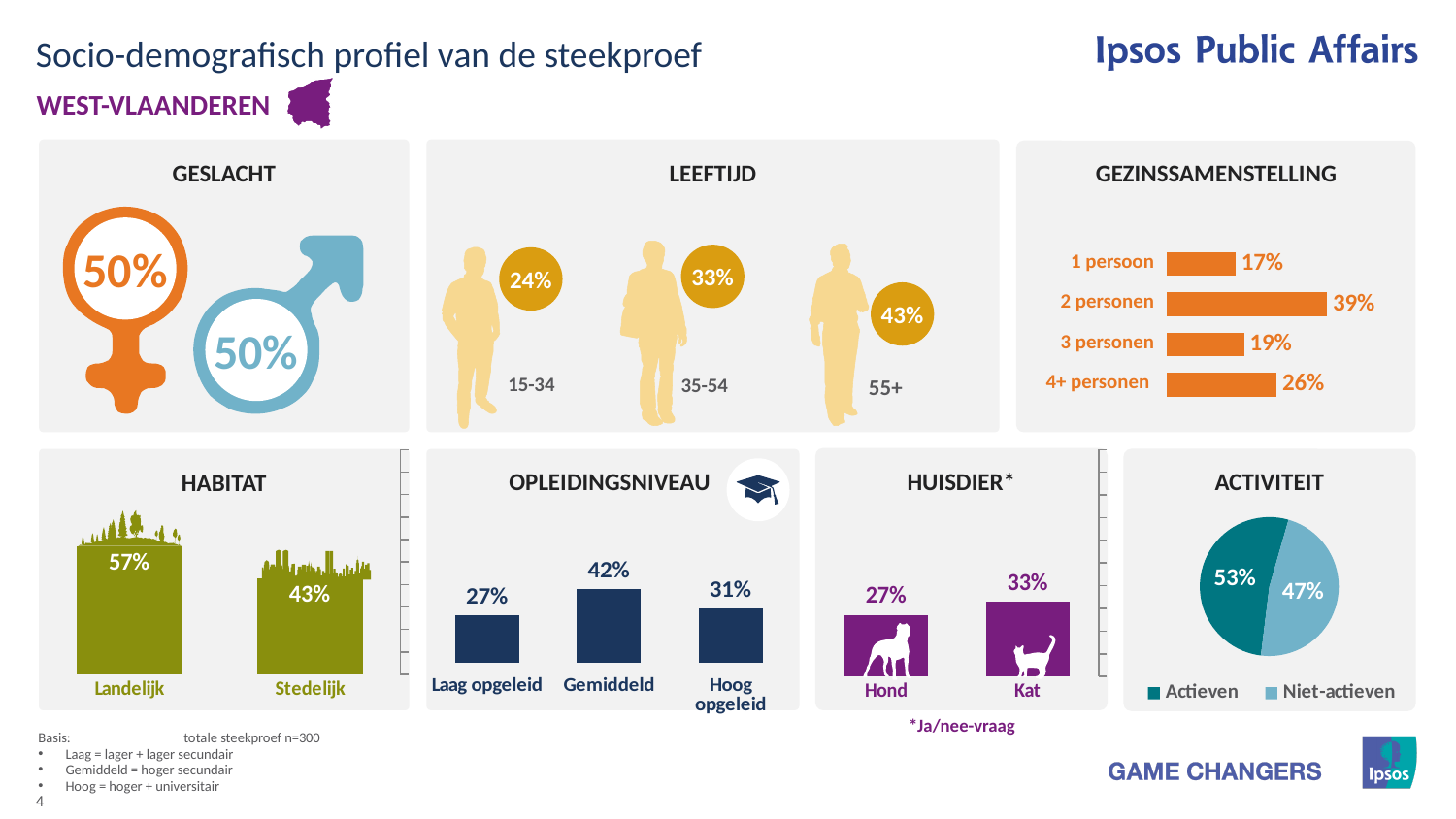
How many categories does the GEZINSSAMENSTELLING chart show? 4 In the ACTIVITEIT pie chart, what share does Actieven have? 53% In the OPLEIDINGSNIVEAU chart, what is the value for Gemiddeld? 42% In the OPLEIDINGSNIVEAU chart, which category has the highest value? Gemiddeld In the HUISDIER chart, which is larger, Hond or Kat? Kat In the GEZINSSAMENSTELLING chart, what is the value for 2 personen? 39% In the GEZINSSAMENSTELLING chart, what is the difference between 4+ personen and 3 personen? 7% In the HUISDIER chart, what is the difference between Kat and Hond? 6% What kind of chart is the OPLEIDINGSNIVEAU chart? bar chart In the GEZINSSAMENSTELLING chart, which category has the lowest value? 1 persoon In the HABITAT chart, what is the value for Landelijk? 57% How many series does the legend of the ACTIVITEIT chart list? 2